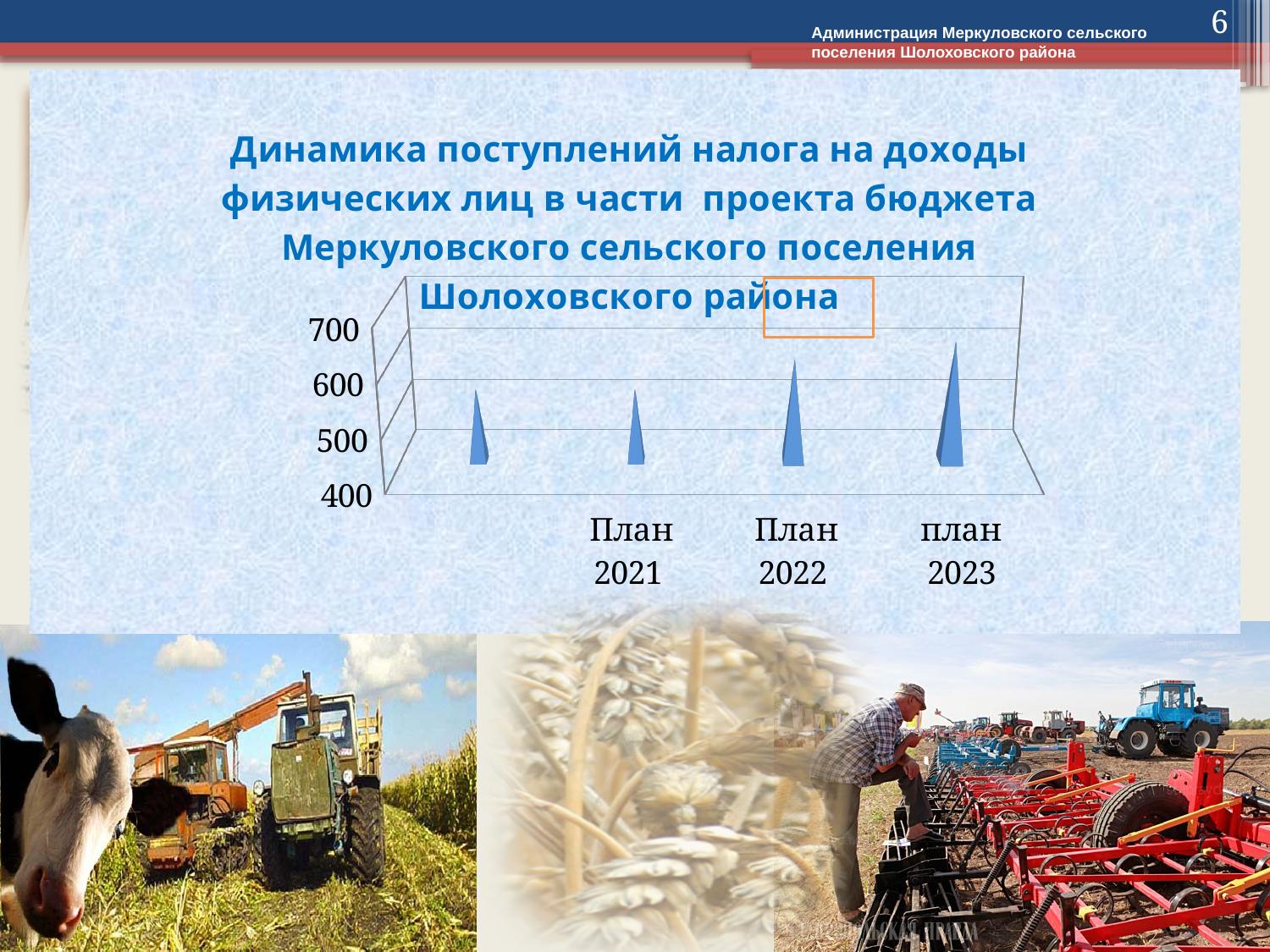
What kind of chart is shown on the slide? bar chart Is the value for план 2023 greater or less than 600? greater What is the lowest value shown on the vertical axis of the chart? 400 Which labelled category has the highest value in the chart? план 2023 How many bars are plotted in the chart? 4 Which is larger, the value for план 2023 or the value for План 2022? план 2023 Is the value for План 2022 greater or less than 700? less Is the value for План 2021 greater or less than 500? greater Which is larger, the value for План 2022 or the value for План 2021? План 2022 Do the values rise or fall from План 2021 to план 2023? rise What is the highest value shown on the vertical axis of the chart? 700